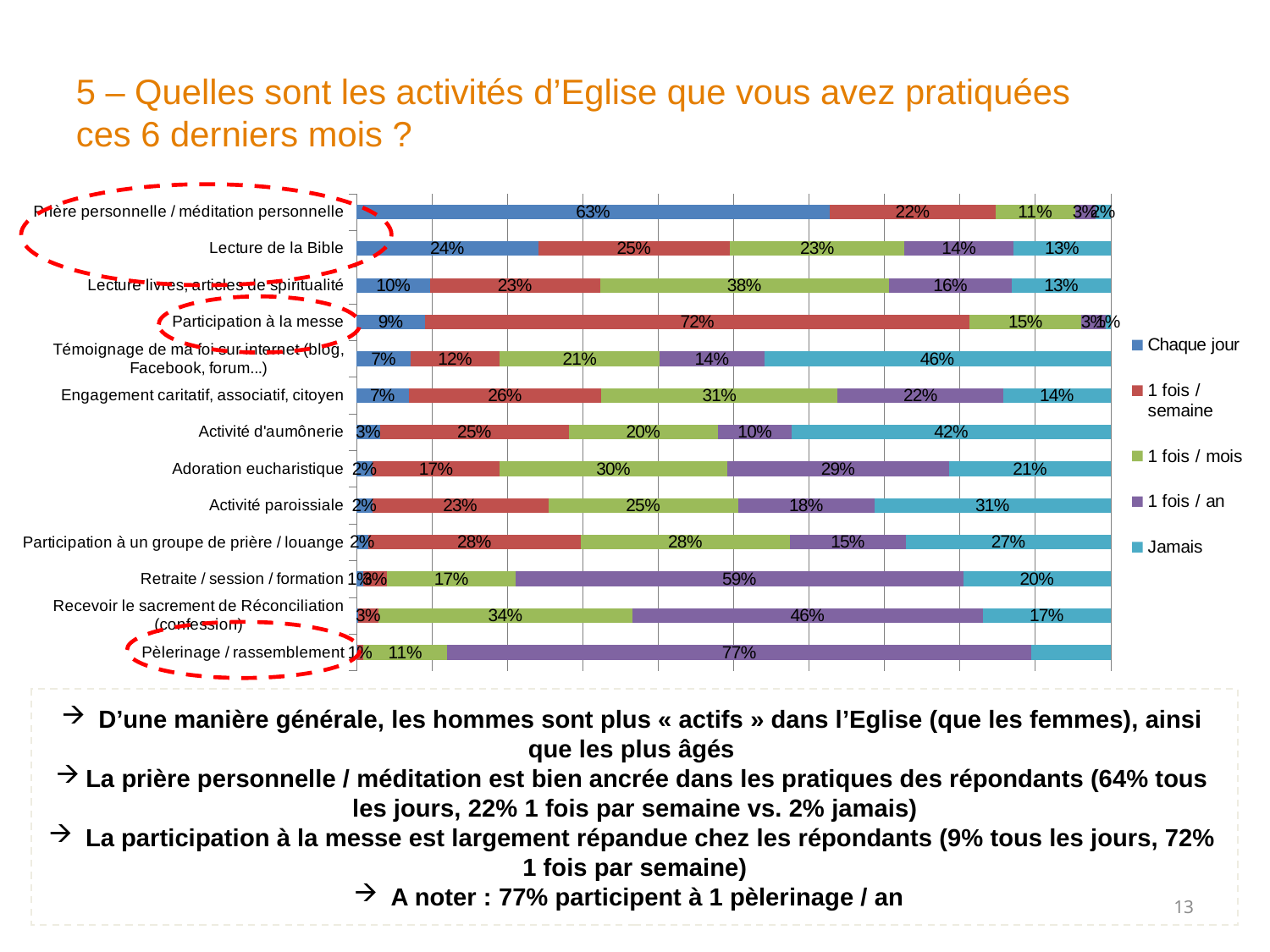
What is the '1 fois / semaine' value for 'Participation à la messe'? 72% How many activity categories are plotted on the chart? 13 What is the '1 fois / an' value for 'Pèlerinage / rassemblement'? 77% Which activity has the highest 'Chaque jour' value? Prière personnelle / méditation personnelle What is the 'Chaque jour' value for 'Prière personnelle / méditation personnelle'? 63% What is the 'Jamais' value for 'Témoignage de ma foi sur internet (blog, Facebook, forum...)'? 46% Which legend entry is shown in green? 1 fois / mois What is the difference between the '1 fois / mois' value for 'Lecture livres, articles de spiritualité' and that for 'Lecture de la Bible'? 15% Which is larger: the 'Jamais' value for 'Activité paroissiale' or the 'Jamais' value for 'Adoration eucharistique'? Activité paroissiale Which activity has the highest 'Jamais' value? Témoignage de ma foi sur internet (blog, Facebook, forum...) How many series does the legend list? 5 What kind of chart is shown on the slide? Stacked bar chart